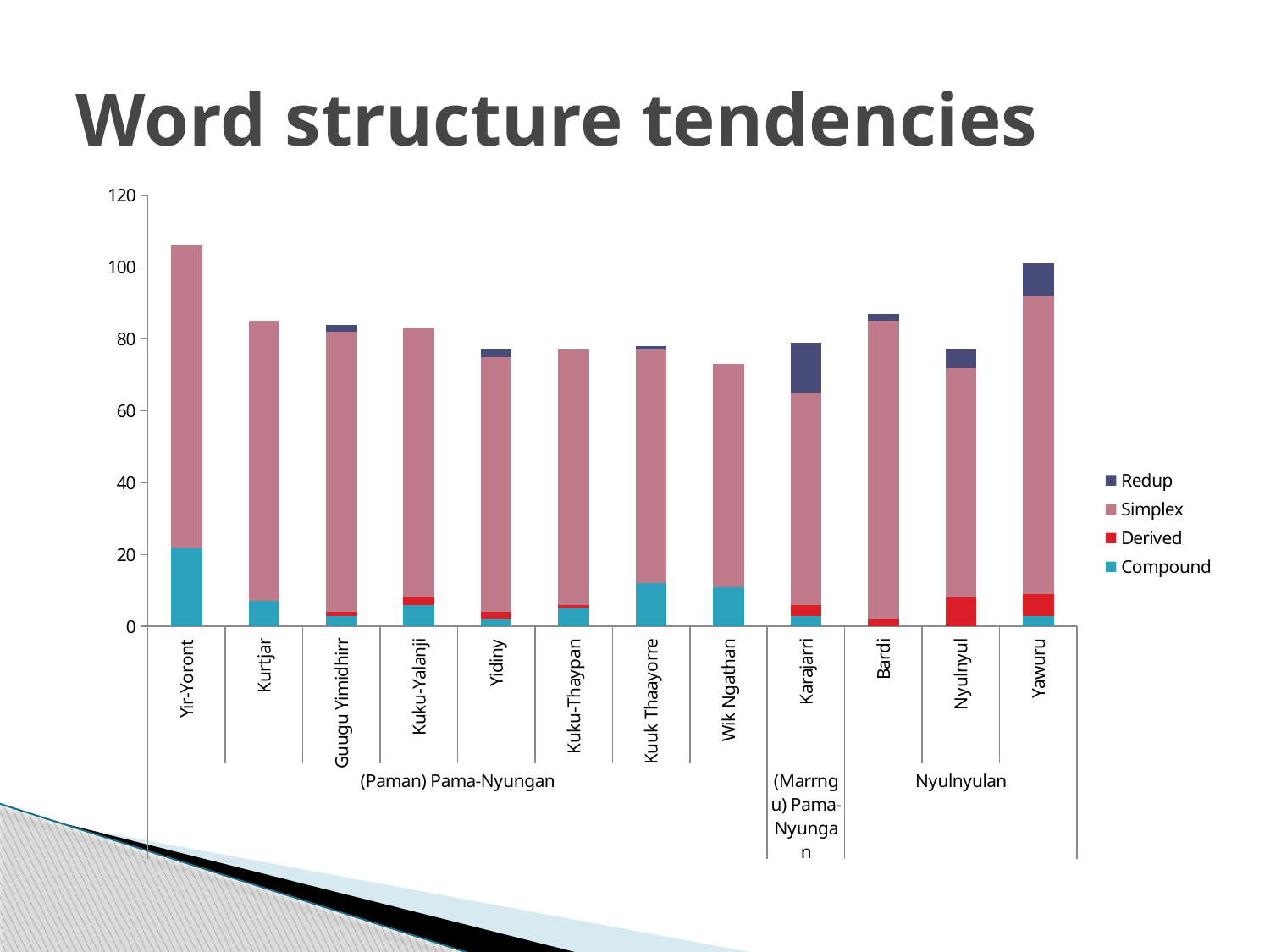
Is the total bar height for Yir-Yoront greater or less than 100? greater Which language has the largest Compound segment? Yir-Yoront How many languages (categories) are plotted along the x axis? 12 How many series does the legend list? 4 Which has the taller stacked bar, Bardi or Wik Ngathan? Bardi What is the title of the chart? Word structure tendencies Which language has the larger Redup segment, Karajarri or Yawuru? Karajarri What kind of chart is shown on the slide? Stacked bar chart Is the total bar height for Kurtjar greater or less than 80? greater Is the total bar height for Wik Ngathan greater or less than 80? less Which language has the shortest stacked bar overall? Wik Ngathan Which language has the tallest stacked bar overall? Yir-Yoront